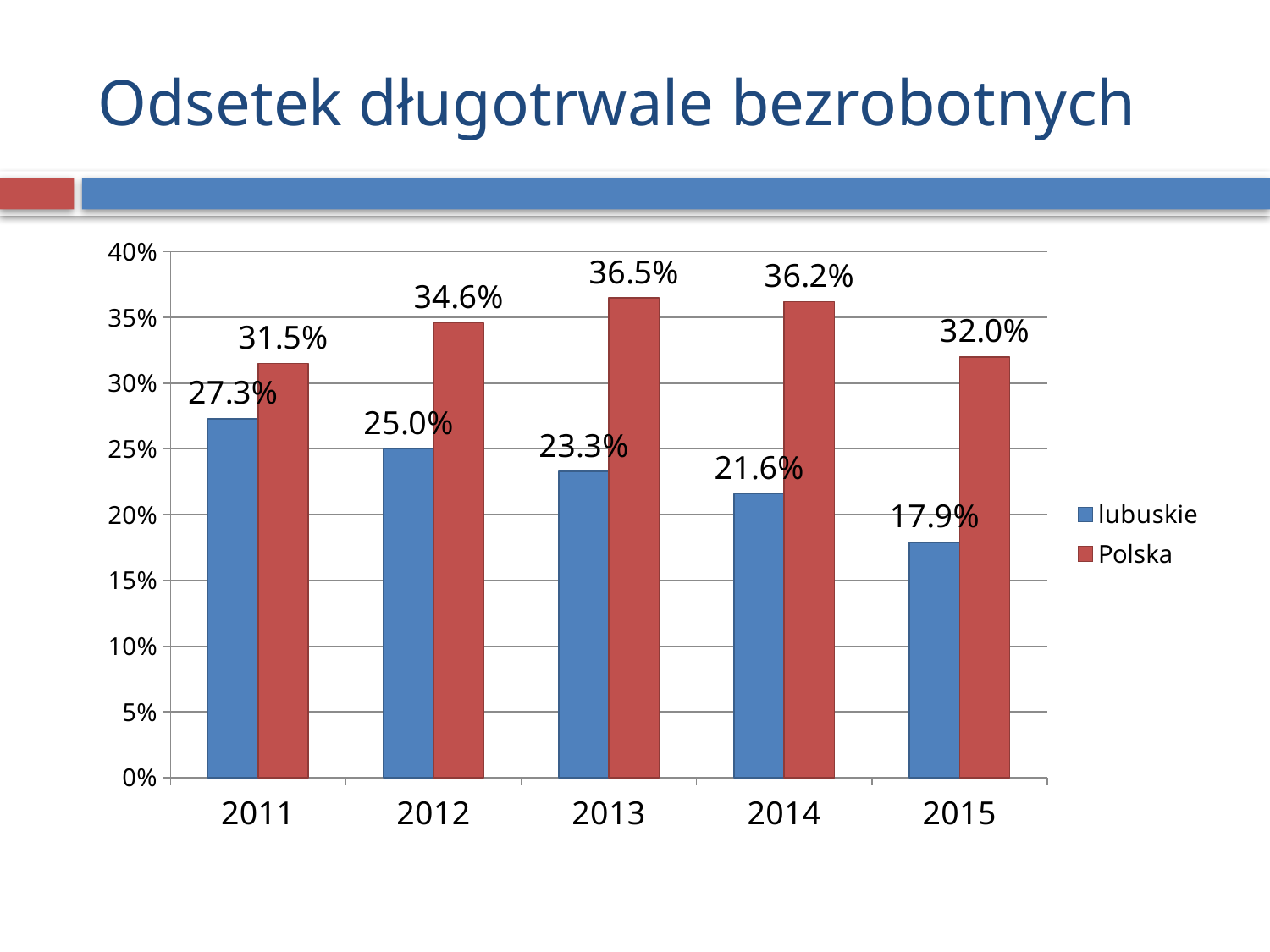
In which year is the lubuskie value lowest? 2015 What is the difference between the Polska and lubuskie values in 2014? 14.6% How many series does the legend list? 2 What is the value for Polska in 2015? 32.0% In which year is the Polska value highest? 2013 Do the lubuskie values rise or fall from 2011 to 2015? fall What is the title of the slide? Odsetek długotrwale bezrobotnych What kind of chart is shown on the slide? bar chart How many years are shown on the x axis? 5 Which is larger in 2011, the lubuskie value or the Polska value? Polska What is the value for lubuskie in 2013? 23.3% Is the value for lubuskie in 2012 greater or less than 20%? greater